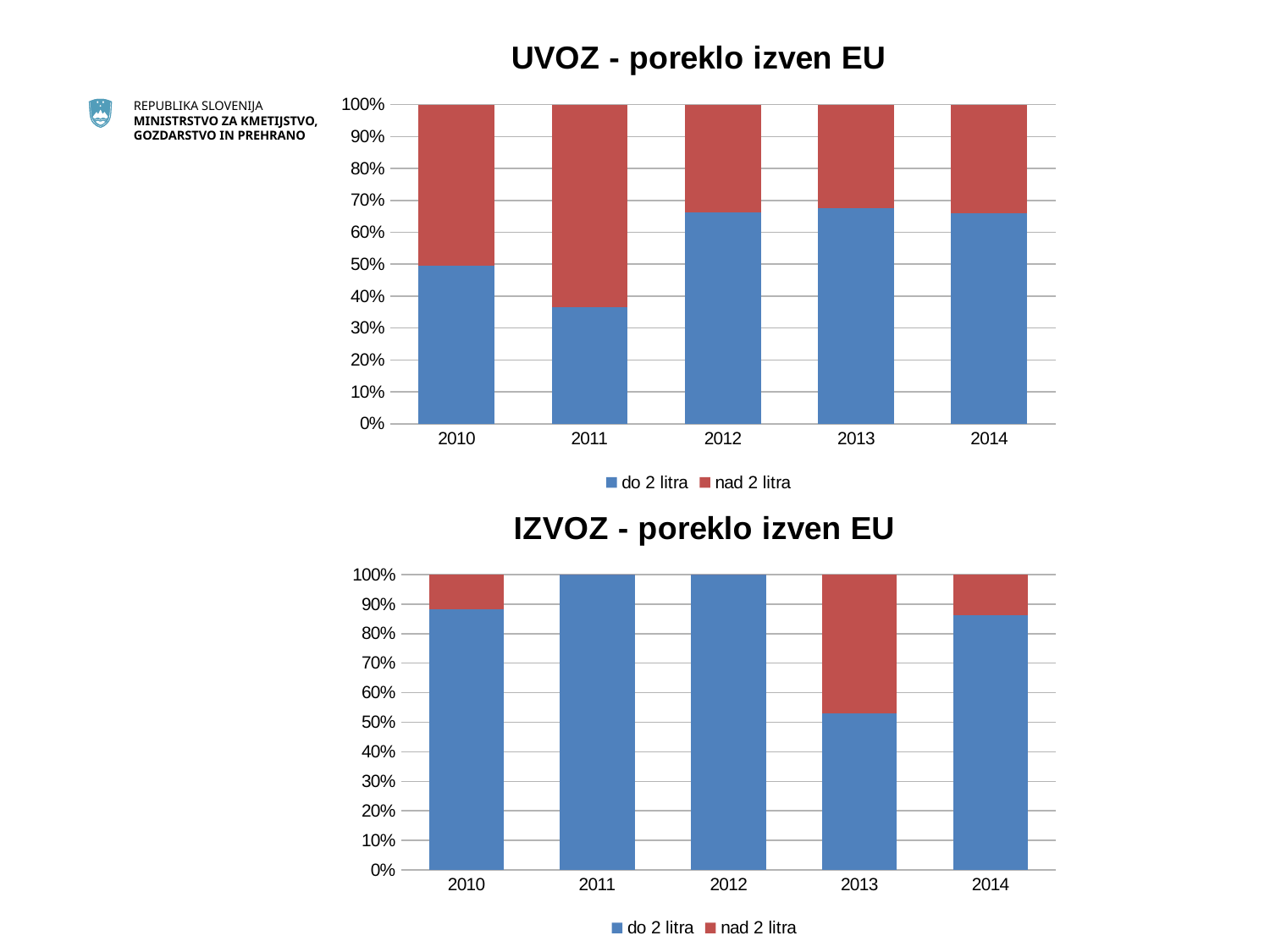
In the UVOZ - poreklo izven EU chart, is the share for do 2 litra in 2011 greater or less than 40%? less What are the two legend entries of the IZVOZ - poreklo izven EU chart? do 2 litra, nad 2 litra How many series does the legend of the IZVOZ - poreklo izven EU chart list? 2 In the UVOZ - poreklo izven EU chart, which year has the highest share for nad 2 litra? 2011 In the UVOZ - poreklo izven EU chart, which is larger for do 2 litra: 2010 or 2011? 2010 In the UVOZ - poreklo izven EU chart, which year has the lowest share for do 2 litra? 2011 In the IZVOZ - poreklo izven EU chart, what is the share for do 2 litra in 2011? 100% In the UVOZ - poreklo izven EU chart, is the share for do 2 litra in 2012 greater or less than 60%? greater In the IZVOZ - poreklo izven EU chart, which year has the lowest share for do 2 litra? 2013 In the IZVOZ - poreklo izven EU chart, is the share for do 2 litra in 2013 greater or less than 60%? less How many years are shown on the x axis of the UVOZ - poreklo izven EU chart? 5 What type of chart is the UVOZ - poreklo izven EU chart? stacked bar chart